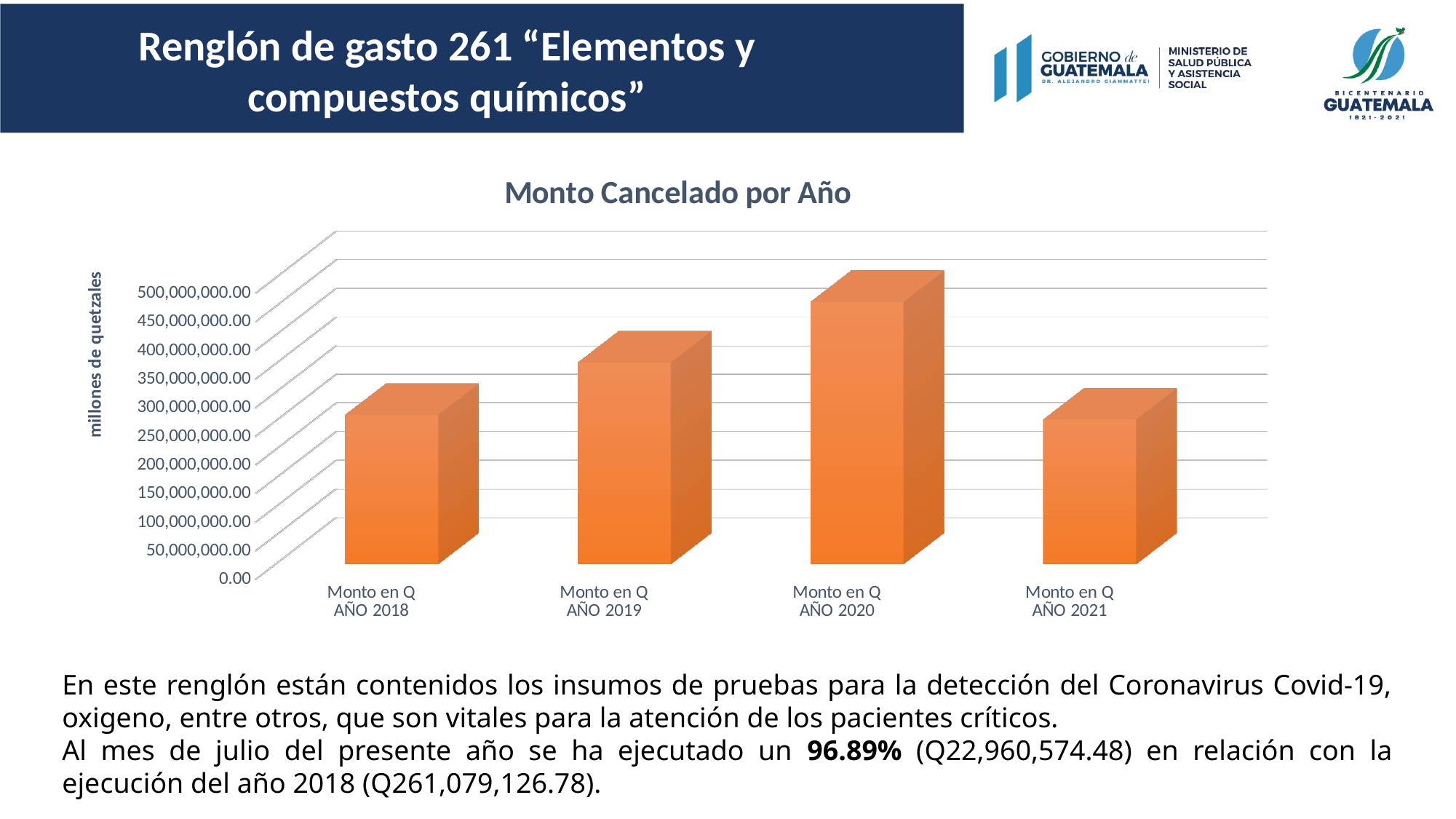
Does the Monto en Q rise or fall from AÑO 2020 to AÑO 2021? fall Is the value for Monto en Q AÑO 2019 greater or less than 300,000,000.00? greater Which is larger, the Monto en Q for AÑO 2019 or for AÑO 2021? AÑO 2019 What kind of chart is shown on the slide? Bar chart Is the value for Monto en Q AÑO 2018 greater or less than 350,000,000.00? less What is the title of the chart? Monto Cancelado por Año What is the label on the vertical axis of the chart? millones de quetzales Does the Monto en Q rise or fall from AÑO 2019 to AÑO 2020? rise Which year has the highest Monto en Q? AÑO 2020 Is the value for Monto en Q AÑO 2020 greater or less than 400,000,000.00? greater How many bars (categories) does the chart show? 4